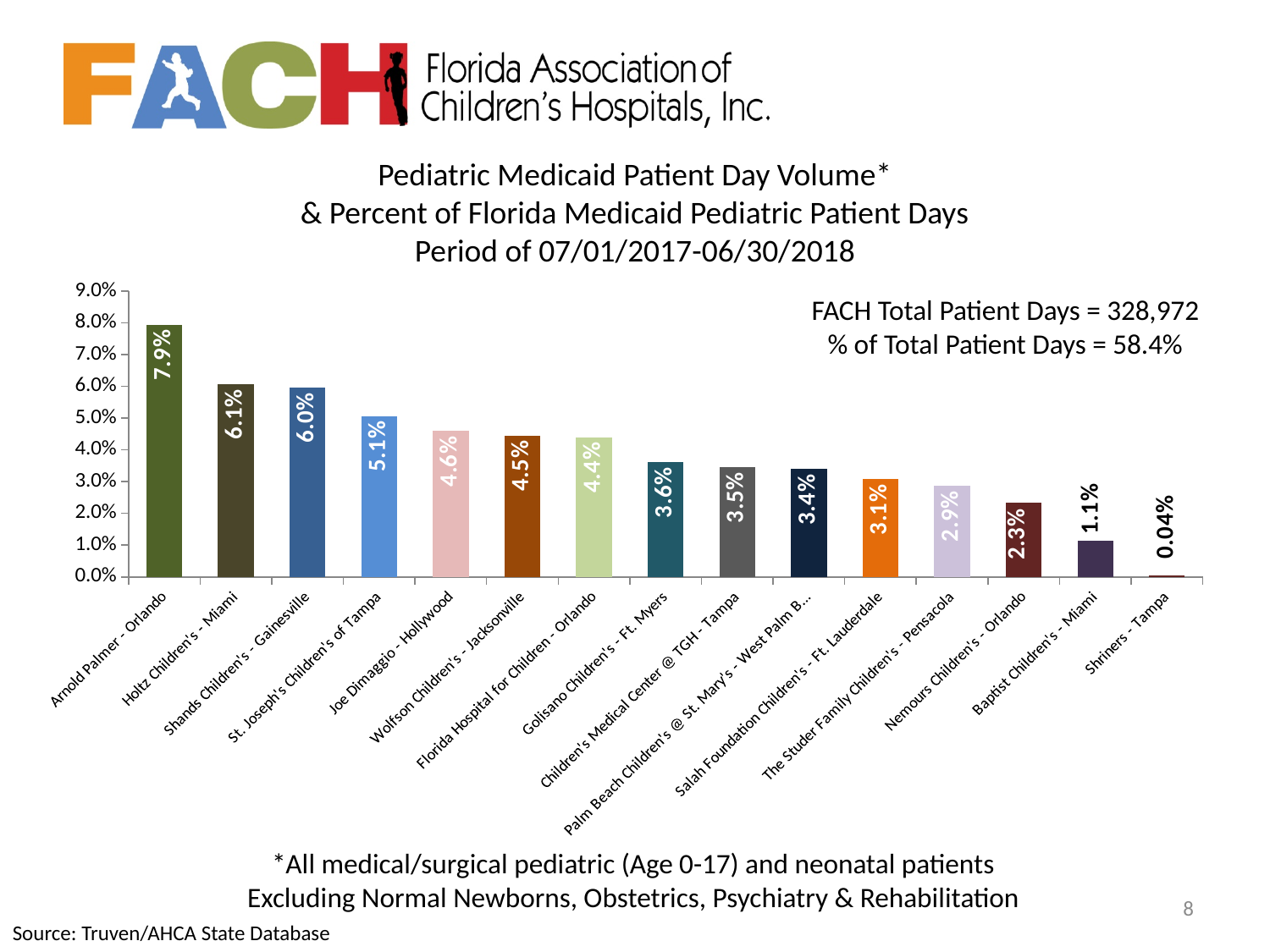
Which is larger, the value for St. Joseph's Children's of Tampa or the value for Golisano Children's - Ft. Myers? St. Joseph's Children's of Tampa What is the difference between the values for Arnold Palmer - Orlando and Holtz Children's - Miami? 1.8% Which hospital has the lowest percentage of Florida Medicaid pediatric patient days? Shriners - Tampa What is the value for Wolfson Children's - Jacksonville? 4.5% What is the value for The Studer Family Children's - Pensacola? 2.9% What is the value for Shriners - Tampa? 0.04% What kind of chart is shown on the slide? bar chart What is the value for Arnold Palmer - Orlando? 7.9% Is the value for Joe DiMaggio - Hollywood greater or less than 4.0%? greater According to the text on the chart, what is the FACH total patient days? 328,972 How many hospitals are shown on the chart? 15 Which hospital has the highest percentage of Florida Medicaid pediatric patient days? Arnold Palmer - Orlando